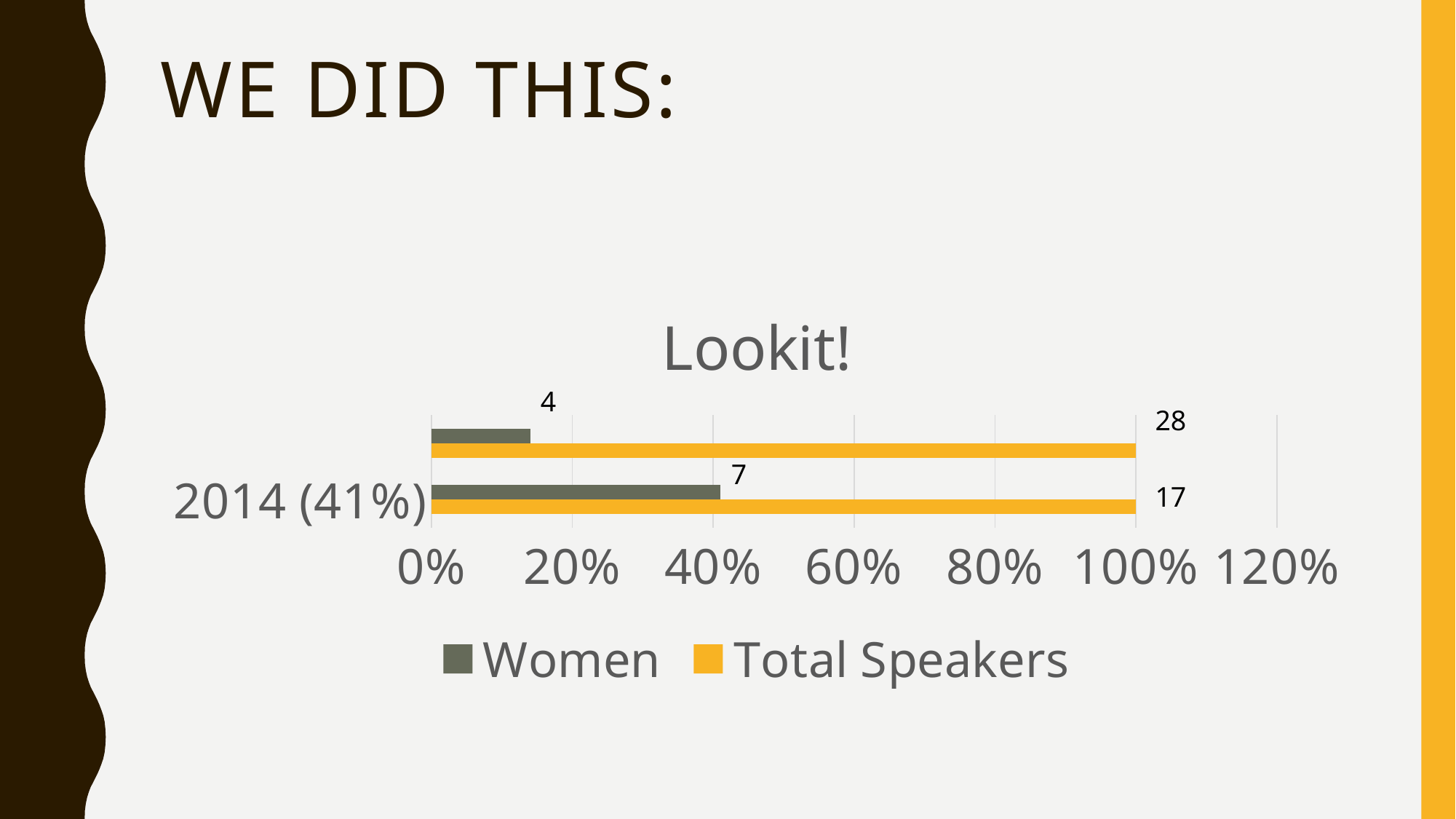
What is the difference between Total Speakers and Women for 2014 (41%)? 10 Is the Women bar for 2014 (41%) greater or less than 60% on the axis? less What is the Women value for 2014 (41%)? 7 How many series does the legend list? 2 What is the Total Speakers value for 2014 (41%)? 17 What is the title of the chart? Lookit! What are the two series named in the legend? Women and Total Speakers Is the Total Speakers bar for 2014 (41%) greater or less than 80% on the axis? greater Is the Women bar for 2014 (41%) greater or less than 20% on the axis? greater What kind of chart is shown on the slide? bar chart For 2014 (41%), which is larger: Women or Total Speakers? Total Speakers How many groups of bars are plotted in the chart? 2